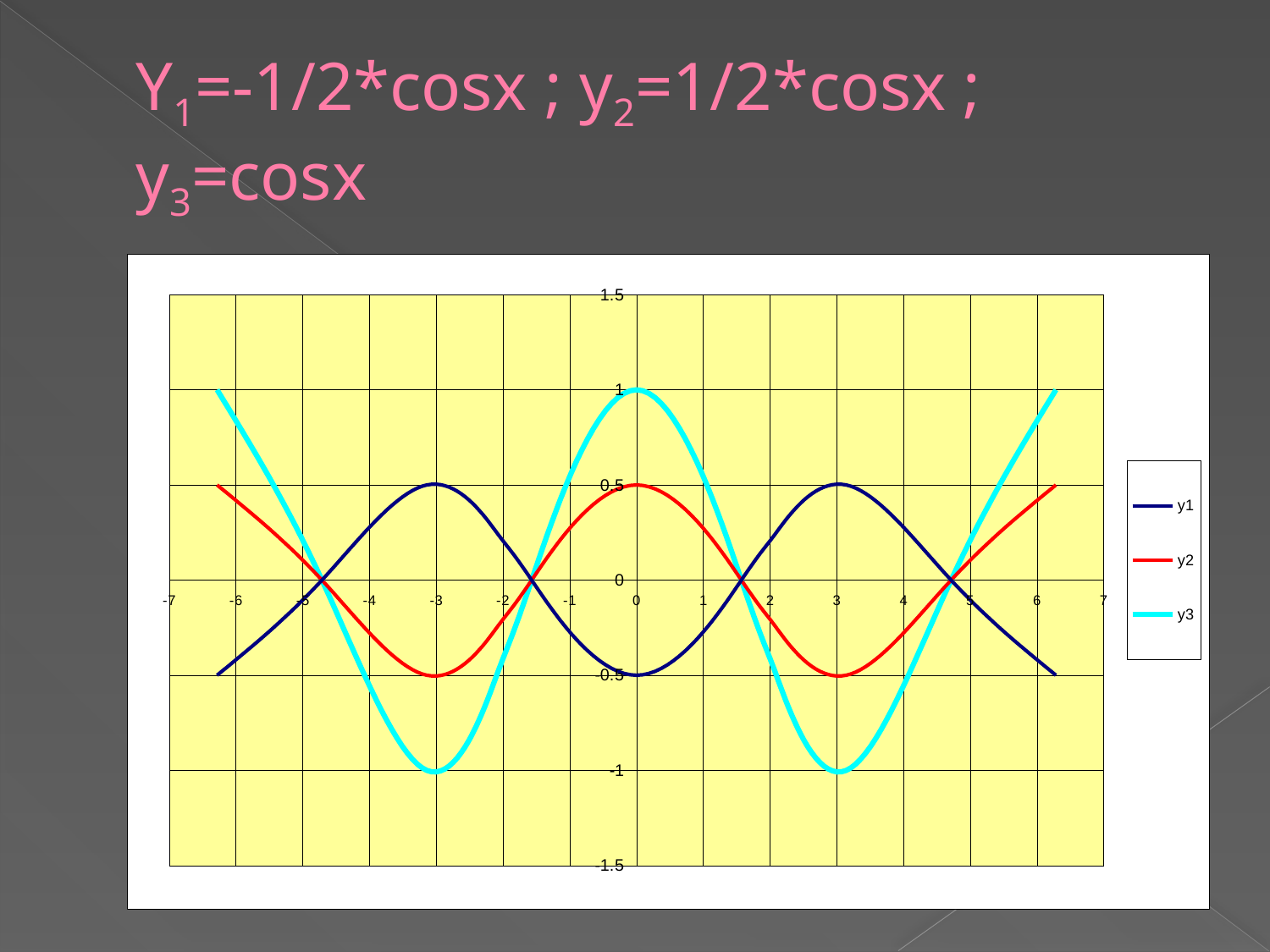
What is the value of y3 at x = 0? 1 What is the difference between y3 and y2 at x = 0? 0.5 Does y3 rise or fall as x goes from 0 to 3? fall What are the series names listed in the legend? y1, y2, y3 What is the value of y3 at x = 3? -1 What is the value of y2 at x = 0? 0.5 At x = 0, which series has the larger value, y2 or y3? y3 What is the value of y1 at x = 0? -0.5 Is the value of y3 at x = -3 greater or less than -0.5? less How many series does the legend list? 3 What kind of chart is shown on the slide? line chart Which series reaches the highest value on the chart? y3